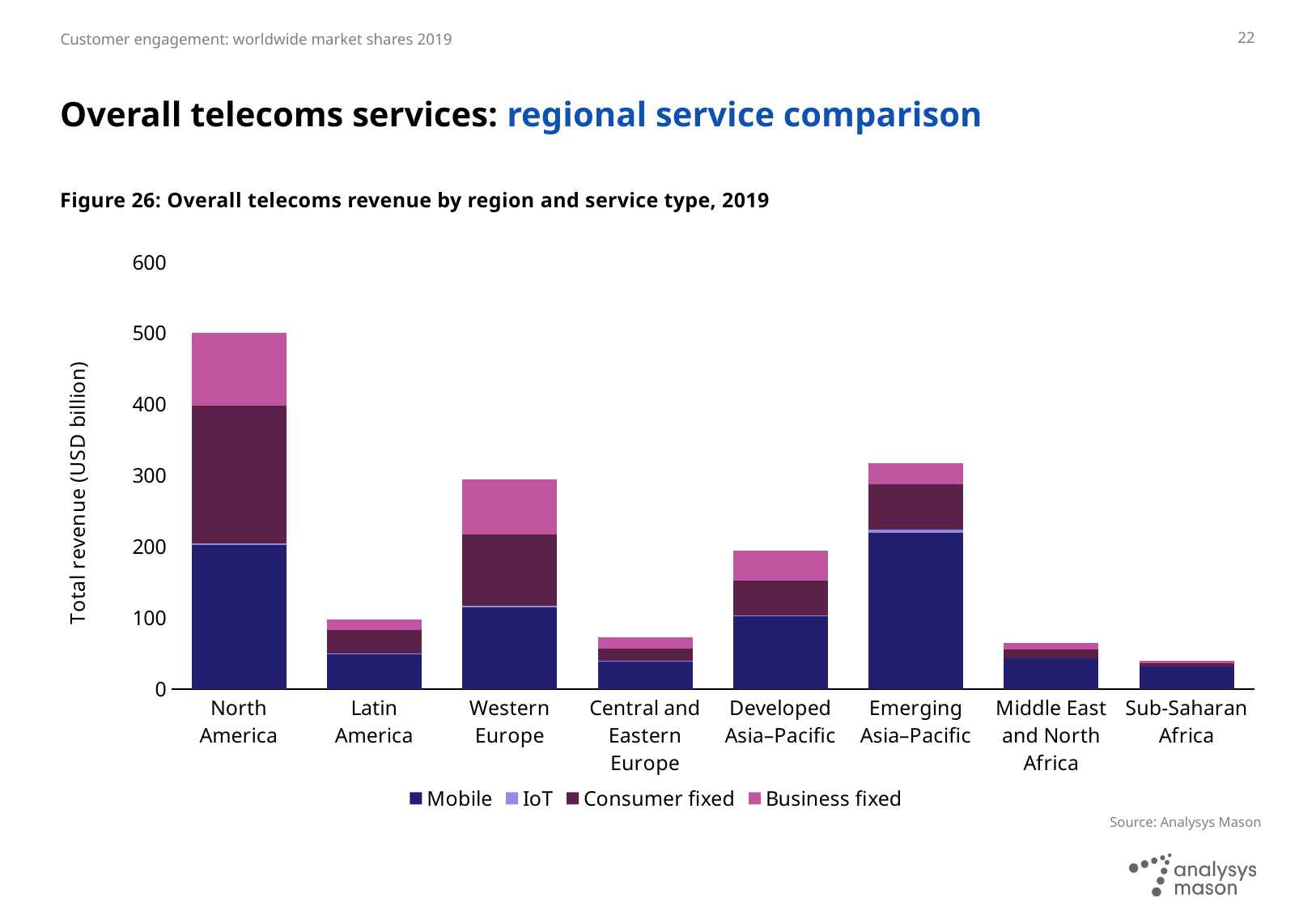
Which region has the lowest total telecoms revenue? Sub-Saharan Africa Is the total revenue for Developed Asia–Pacific greater or less than 300? less Is the total revenue for Western Europe greater or less than 200? greater How many regions are shown on the x axis of the chart? 8 What kind of chart is shown in Figure 26? Stacked bar chart Which has the larger total revenue, Emerging Asia–Pacific or Western Europe? Emerging Asia–Pacific Is the total revenue for Latin America greater or less than 200? less What is the label on the y axis of the chart? Total revenue (USD billion) Which series is shown in the darkest blue colour at the bottom of each bar? Mobile Which region has the highest total telecoms revenue? North America How many series does the legend list? 4